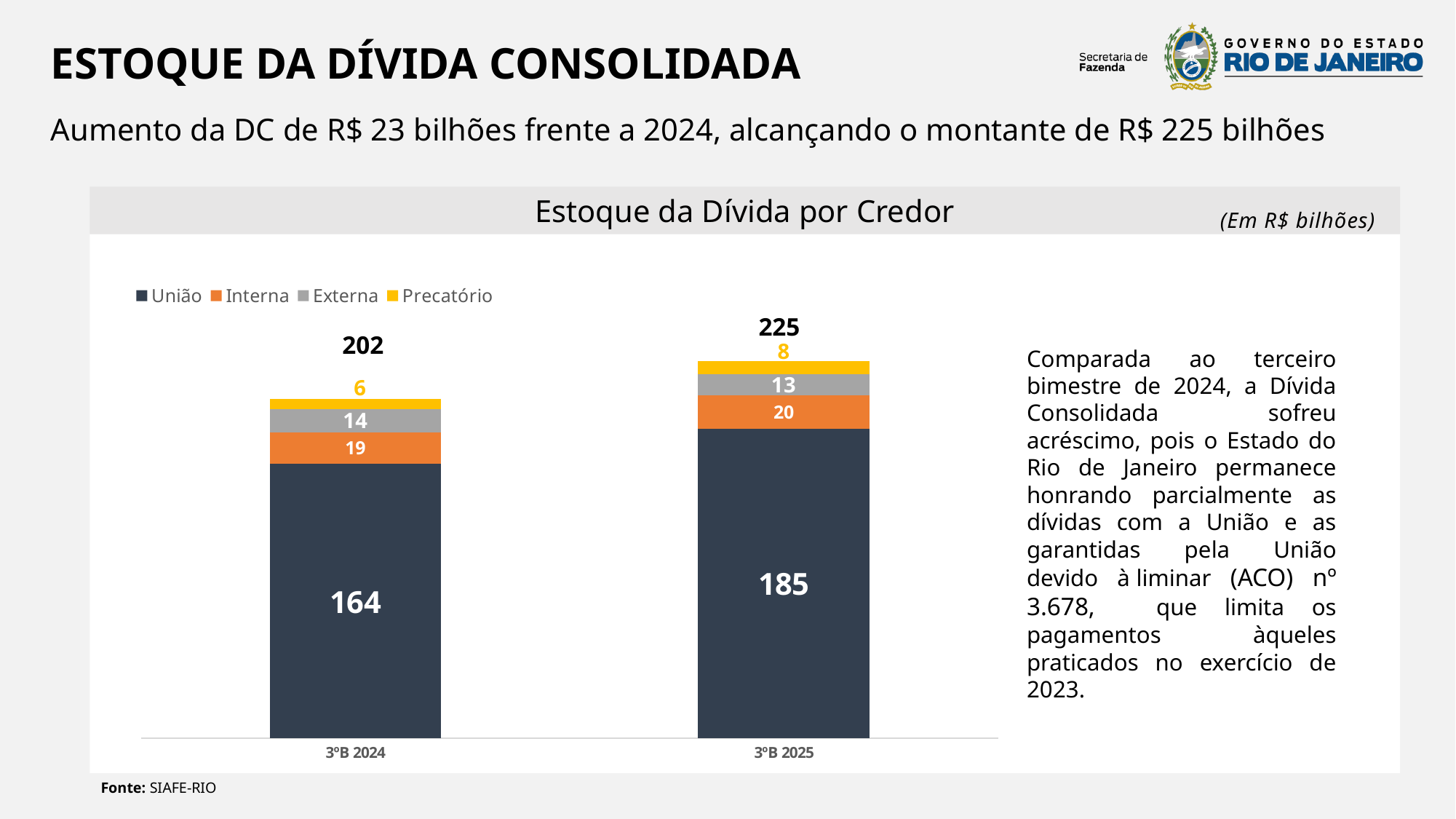
What is the value of Precatório for 3ºB 2024? 6 What is the value of Externa for 3ºB 2025? 13 What is the value of Interna for 3ºB 2024? 19 Is the Externa value larger for 3ºB 2024 or 3ºB 2025? 3ºB 2024 What is the total of the stacked bar for 3ºB 2025? 225 What is the total of the stacked bar for 3ºB 2024? 202 What is the difference between the União values for 3ºB 2025 and 3ºB 2024? 21 What type of chart is shown? Stacked bar chart How many series does the legend list? 4 What is the value of União for 3ºB 2025? 185 Which series has the smallest value in the 3ºB 2025 bar? Precatório Which series has the largest value in the 3ºB 2024 bar? União